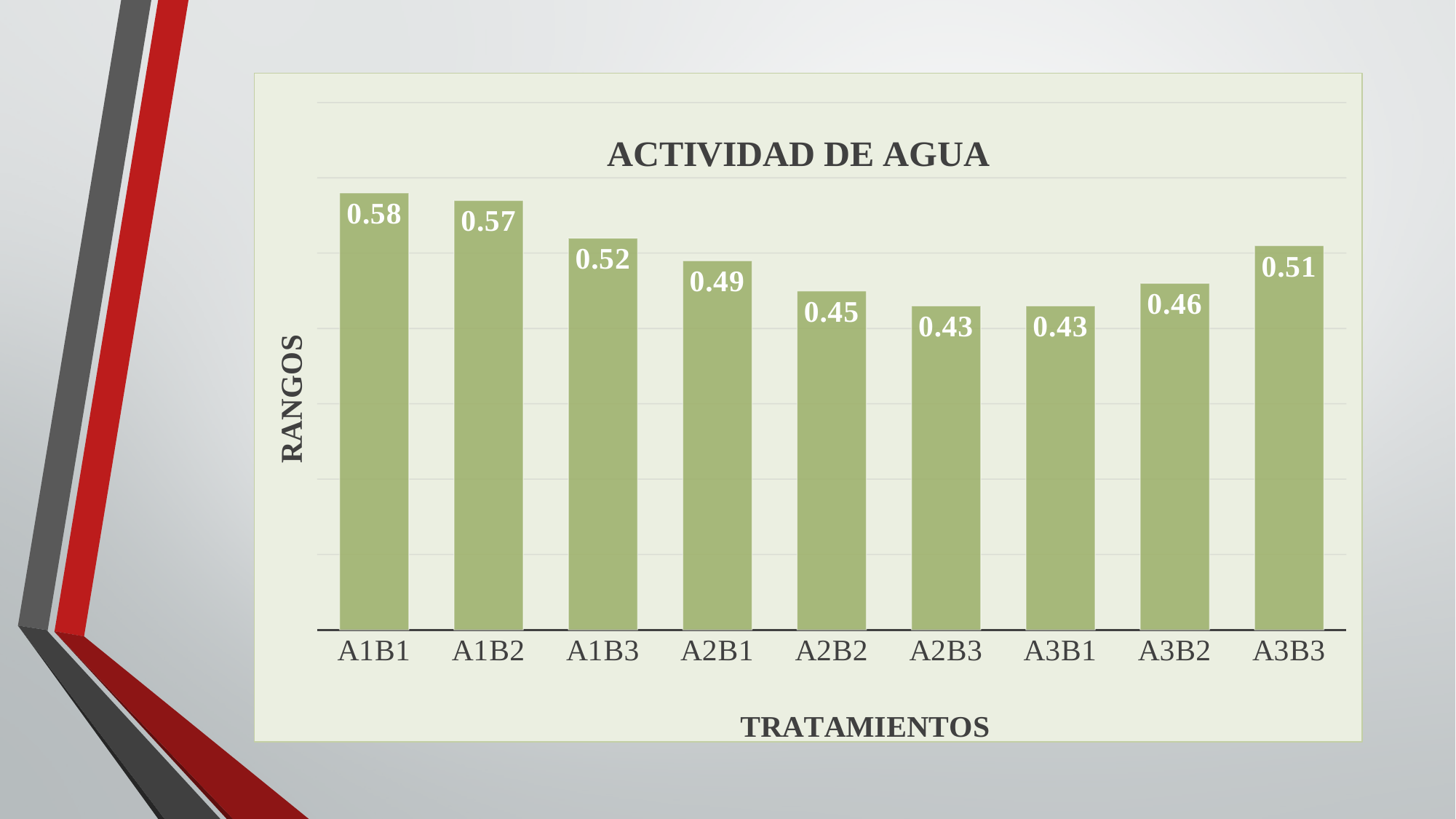
Which is larger, the value for A2B1 or the value for A3B2? A2B1 What is the difference between the values for A1B1 and A2B3? 0.15 What kind of chart is this? Bar chart Which is larger, the value for A1B2 or the value for A3B3? A1B2 What is the title of the chart? ACTIVIDAD DE AGUA What is the difference between the values for A1B3 and A3B2? 0.06 What is the value for A3B3? 0.51 How many treatments are shown on the x axis? 9 What is the label of the x axis? TRATAMIENTOS What is the value for A2B2? 0.45 What is the value for A1B1? 0.58 Which treatment has the highest value? A1B1